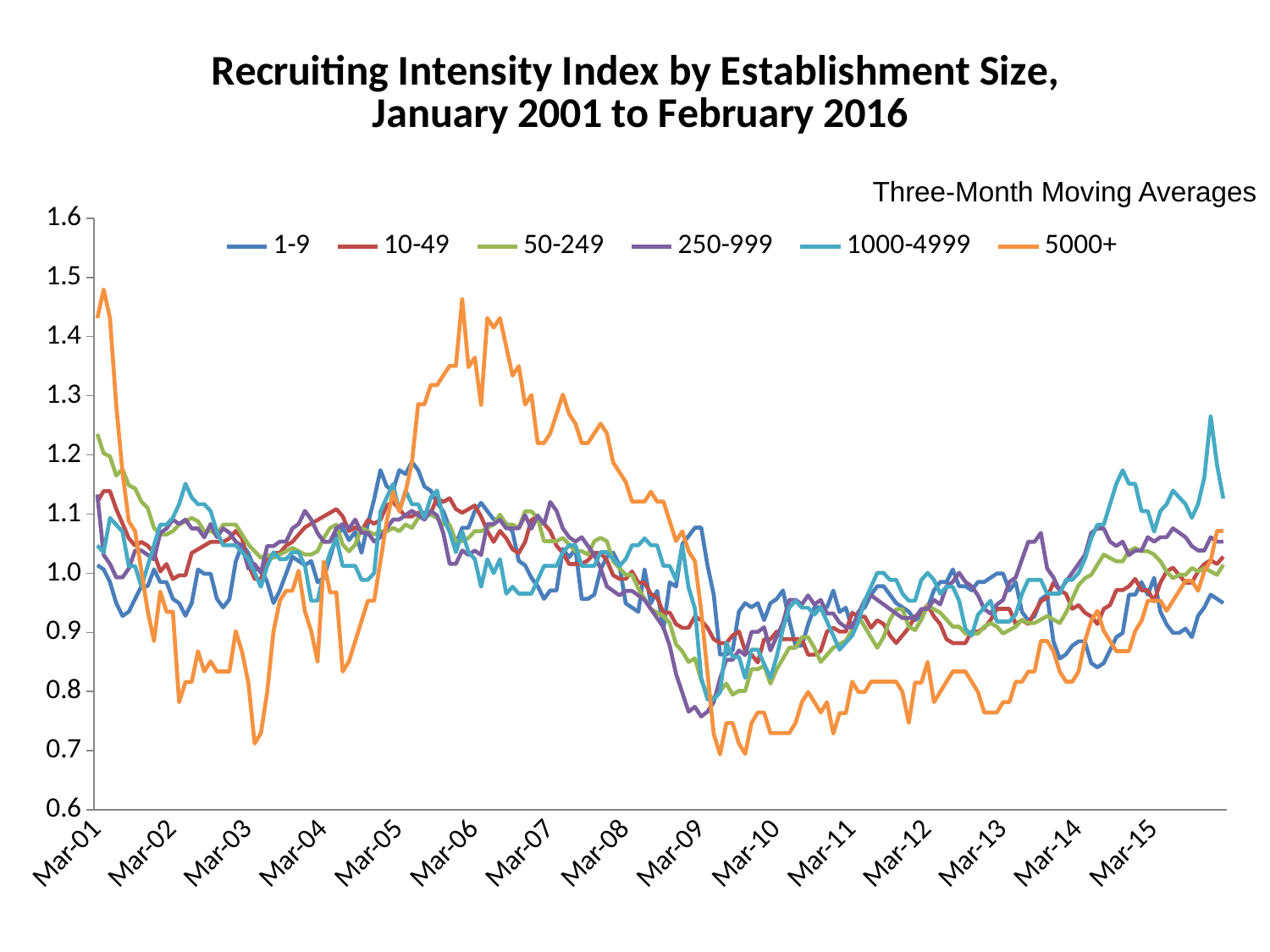
Does the 5000+ series rise or fall between Mar-06 and Mar-09? fall How many series does the legend list? 6 Is the value for the 5000+ series at Mar-03 greater or less than 0.9? less Which series reaches the lowest value anywhere on the chart? 5000+ What note appears above the legend describing how the series are computed? Three-Month Moving Averages Is the value for the 5000+ series at Mar-10 greater or less than 0.8? less Is the value for the 5000+ series at Mar-06 greater or less than 1.3? greater What kind of chart is shown on the slide? Line chart Which series reaches the highest value anywhere on the chart? 5000+ What is the title of the chart? Recruiting Intensity Index by Establishment Size, January 2001 to February 2016 At Mar-15, which is larger: the 1000-4999 series or the 5000+ series? 1000-4999